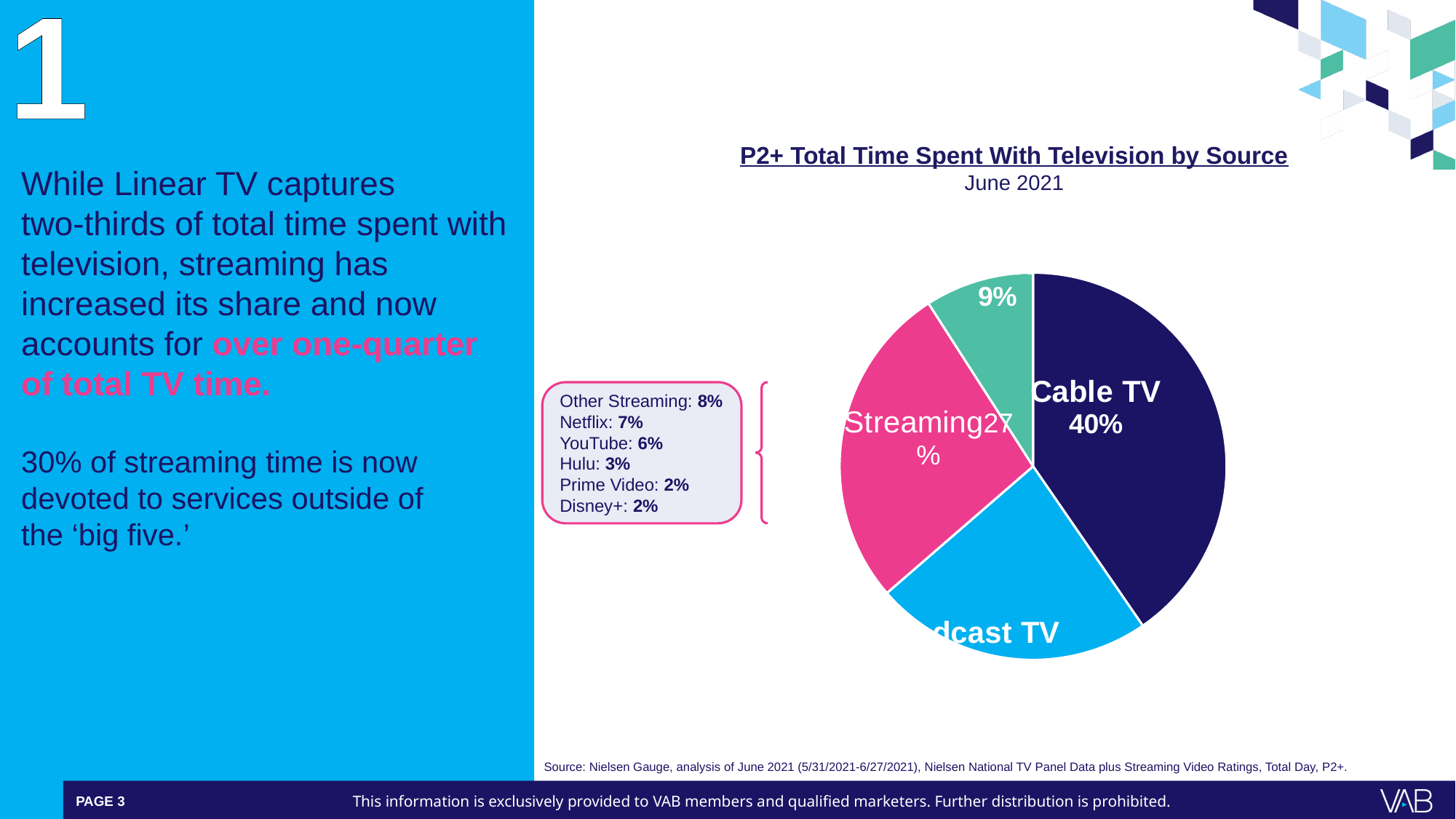
What share of total time spent with television does Streaming account for? 27% According to the callout box, what share does Hulu account for? 3% What is the title of the pie chart? P2+ Total Time Spent With Television by Source What share of total time spent with television does Cable TV account for? 40% What is the smallest percentage shown on the pie chart? 9% By how many percentage points does Cable TV's share exceed Streaming's share? 13 percentage points How many slices does the pie chart have? 4 Which has the larger share, Cable TV or Streaming? Cable TV According to the callout box, what share does Netflix account for? 7% What kind of chart is shown on the slide? pie chart Which source has the largest share of total time spent with television? Cable TV Which month and year does the pie chart cover? June 2021